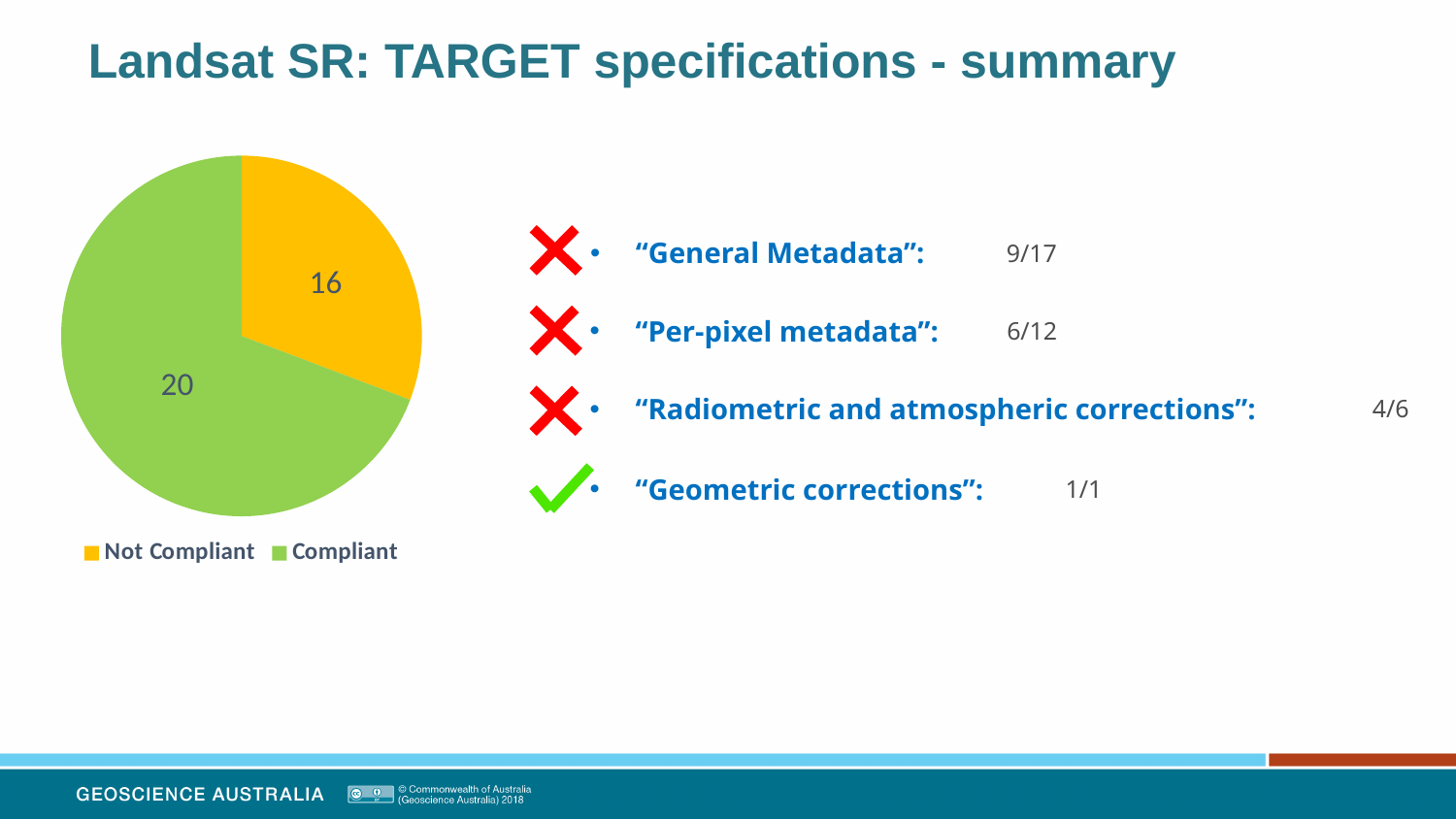
How many slices does the pie chart have? 2 What colour is the Compliant slice in the pie chart? green Which slice of the pie chart is the largest? Compliant How many entries does the pie chart legend list? 2 What is the value for the Not Compliant slice of the pie chart? 16 Which slice of the pie chart is the smallest? Not Compliant What is the total of all slices in the pie chart? 36 What type of chart is shown on the slide? pie chart Which is larger in the pie chart, Compliant or Not Compliant? Compliant What colour is the Not Compliant slice in the pie chart? yellow What is the value for the Compliant slice of the pie chart? 20 What is the difference between the Compliant and Not Compliant values in the pie chart? 4